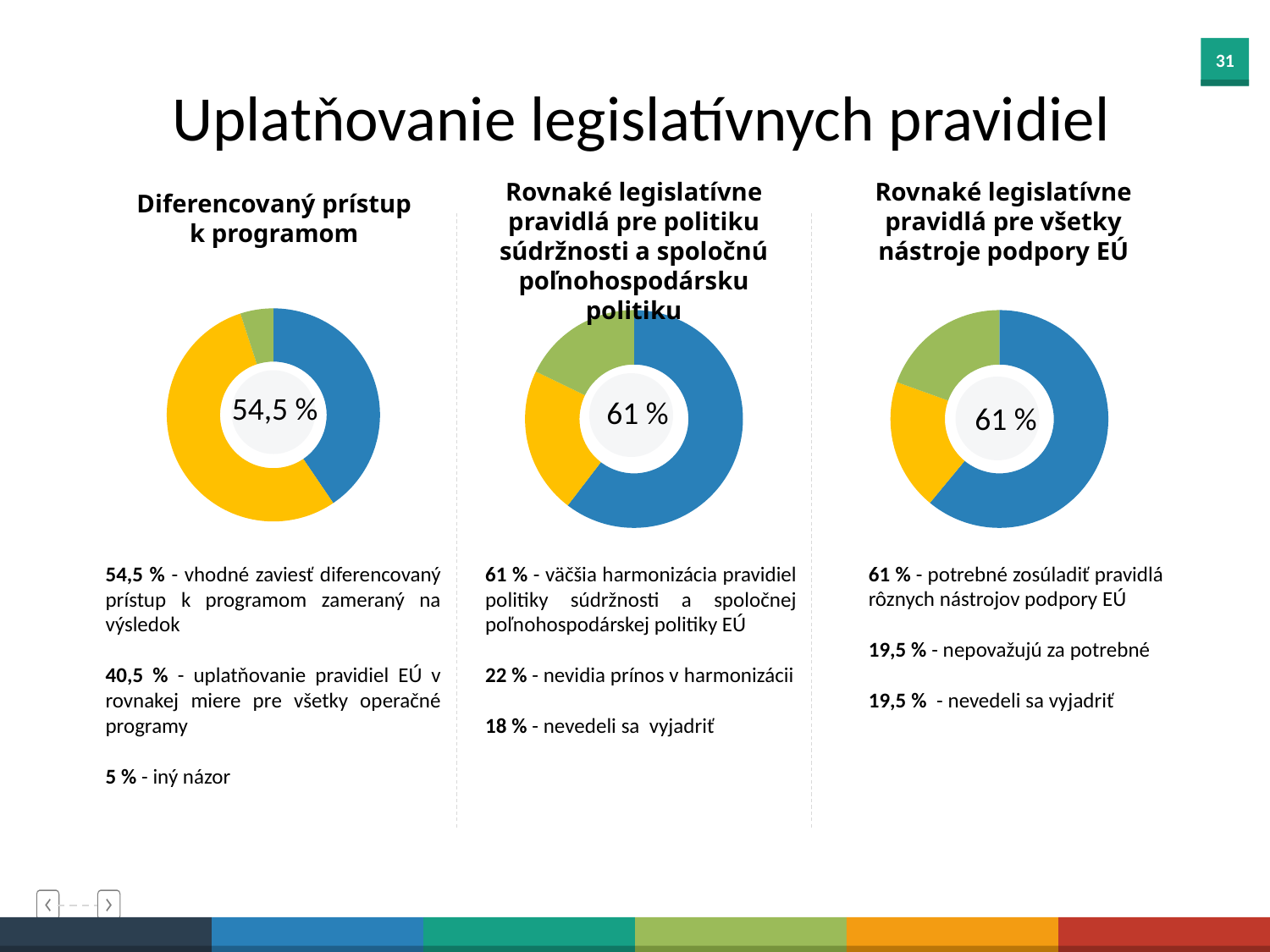
What kind of chart is used for "Diferencovaný prístup k programom"? Donut (pie) chart In the middle chart ("Rovnaké legislatívne pravidlá pre politiku súdržnosti a spoločnú poľnohospodársku politiku"), what value is shown in the centre of the donut? 61 % In the chart "Diferencovaný prístup k programom", what is the difference between the largest slice (54,5 %) and the second slice (40,5 %)? 14 percentage points In the middle chart, which is larger: the share that "nevidia prínos v harmonizácii" or the share that "nevedeli sa vyjadriť"? nevidia prínos v harmonizácii (22 %) In the chart "Diferencovaný prístup k programom", what share of respondents chose "iný názor"? 5 % In the middle chart, what share of respondents "nevidia prínos v harmonizácii"? 22 % How many donut charts are shown on the slide? 3 In the middle chart, which category has the smallest share? nevedeli sa vyjadriť (18 %) In the chart "Diferencovaný prístup k programom", what value is shown in the centre of the donut? 54,5 % How many slices does the donut chart "Diferencovaný prístup k programom" have? 3 In the right-hand chart ("Rovnaké legislatívne pravidlá pre všetky nástroje podpory EÚ"), what share of respondents "nepovažujú za potrebné"? 19,5 % In the right-hand chart, which category has the largest share? potrebné zosúladiť pravidlá rôznych nástrojov podpory EÚ (61 %)